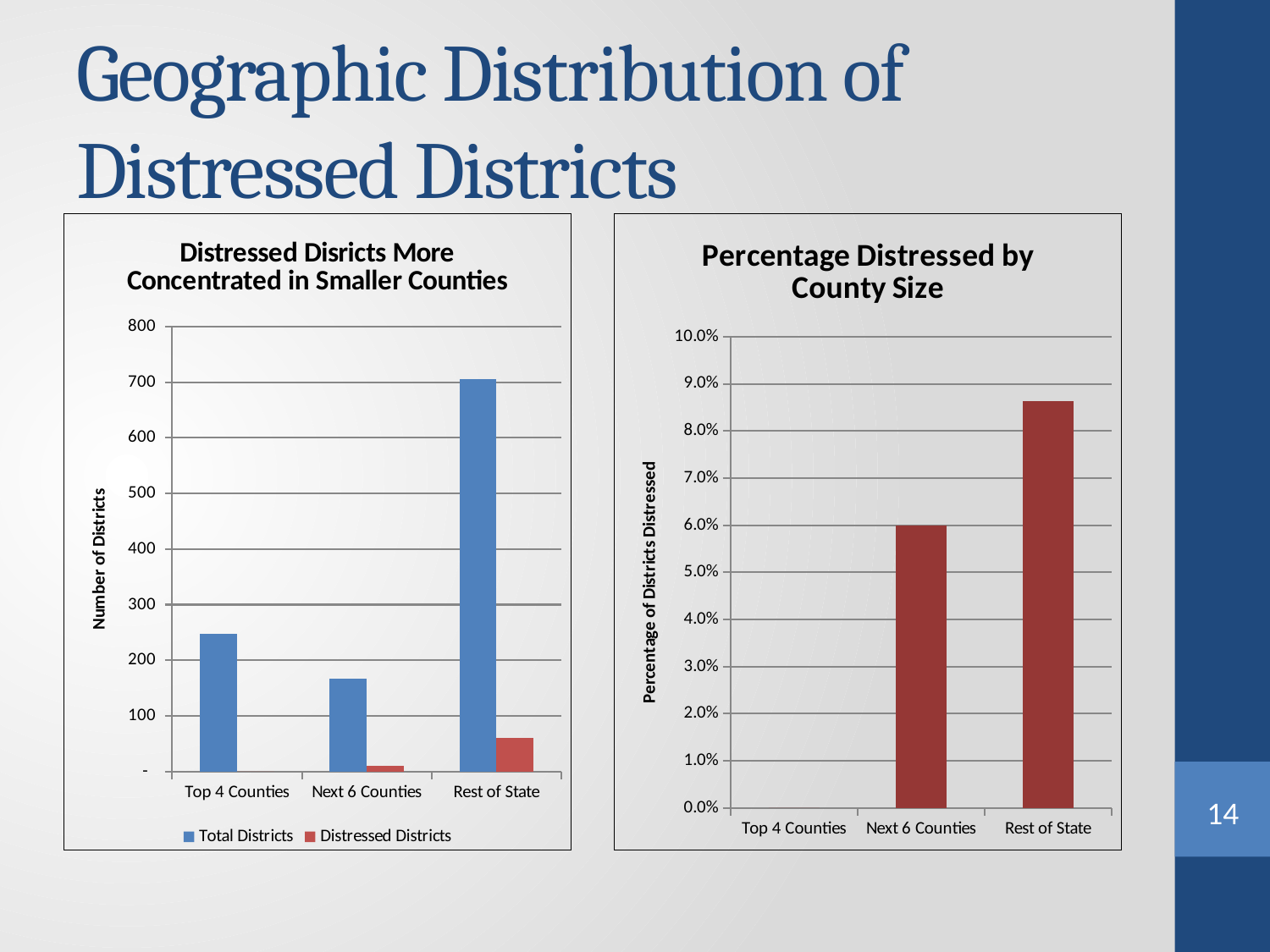
In the chart titled "Percentage Distressed by County Size", which category has the highest percentage of districts distressed? Rest of State In the chart titled "Distressed Disricts More Concentrated in Smaller Counties", is the Total Districts value for Top 4 Counties greater or less than 300? less In the chart titled "Percentage Distressed by County Size", is the value for Rest of State greater or less than 8.0%? greater In the chart titled "Distressed Disricts More Concentrated in Smaller Counties", which has more Total Districts, Top 4 Counties or Next 6 Counties? Top 4 Counties In the chart titled "Distressed Disricts More Concentrated in Smaller Counties", how many series does the legend list? 2 In the chart titled "Distressed Disricts More Concentrated in Smaller Counties", how many categories are shown on the x axis? 3 In the chart titled "Percentage Distressed by County Size", do the values rise or fall moving from Top 4 Counties to Rest of State along the x axis? rise In the chart titled "Distressed Disricts More Concentrated in Smaller Counties", what kind of chart is shown? bar chart In the chart titled "Percentage Distressed by County Size", what kind of chart is shown? bar chart In the chart titled "Distressed Disricts More Concentrated in Smaller Counties", which category has the highest value for Total Districts? Rest of State In the chart titled "Distressed Disricts More Concentrated in Smaller Counties", which category has the lowest value for Total Districts? Next 6 Counties In the chart titled "Distressed Disricts More Concentrated in Smaller Counties", is the Total Districts value for Rest of State greater or less than 600? greater